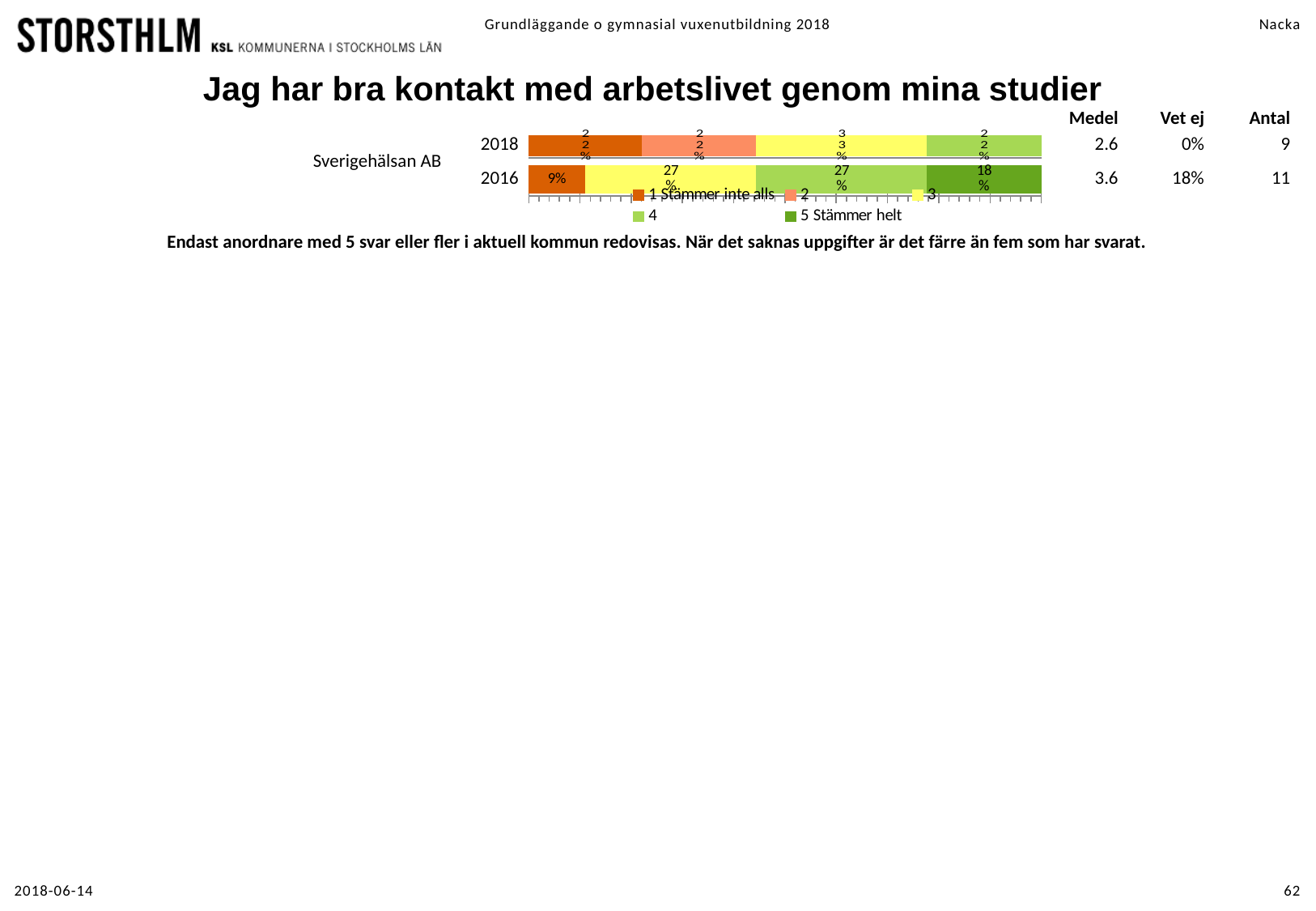
In the 2016 bar, which is larger: the '5 Stämmer helt' segment or the '1 Stämmer inte alls' segment? 5 Stämmer helt What is the difference between the '3' segment and the '1 Stämmer inte alls' segment in the 2016 bar? 18 percentage points What is the value of the '1 Stämmer inte alls' segment in the 2016 bar? 9% What is the value of the '3' segment in the 2018 bar? 33% How many series does the chart legend list? 5 Which response category has the largest share in the 2018 bar? 3 How many bars (years) are plotted for Sverigehälsan AB? 2 What kind of chart is shown on the slide? Stacked bar chart Which response category has the smallest share in the 2016 bar? 1 Stämmer inte alls What is the value of the '1 Stämmer inte alls' segment in the 2018 bar? 22% What is the value of the '5 Stämmer helt' segment in the 2016 bar? 18% What is the title of the chart? Jag har bra kontakt med arbetslivet genom mina studier